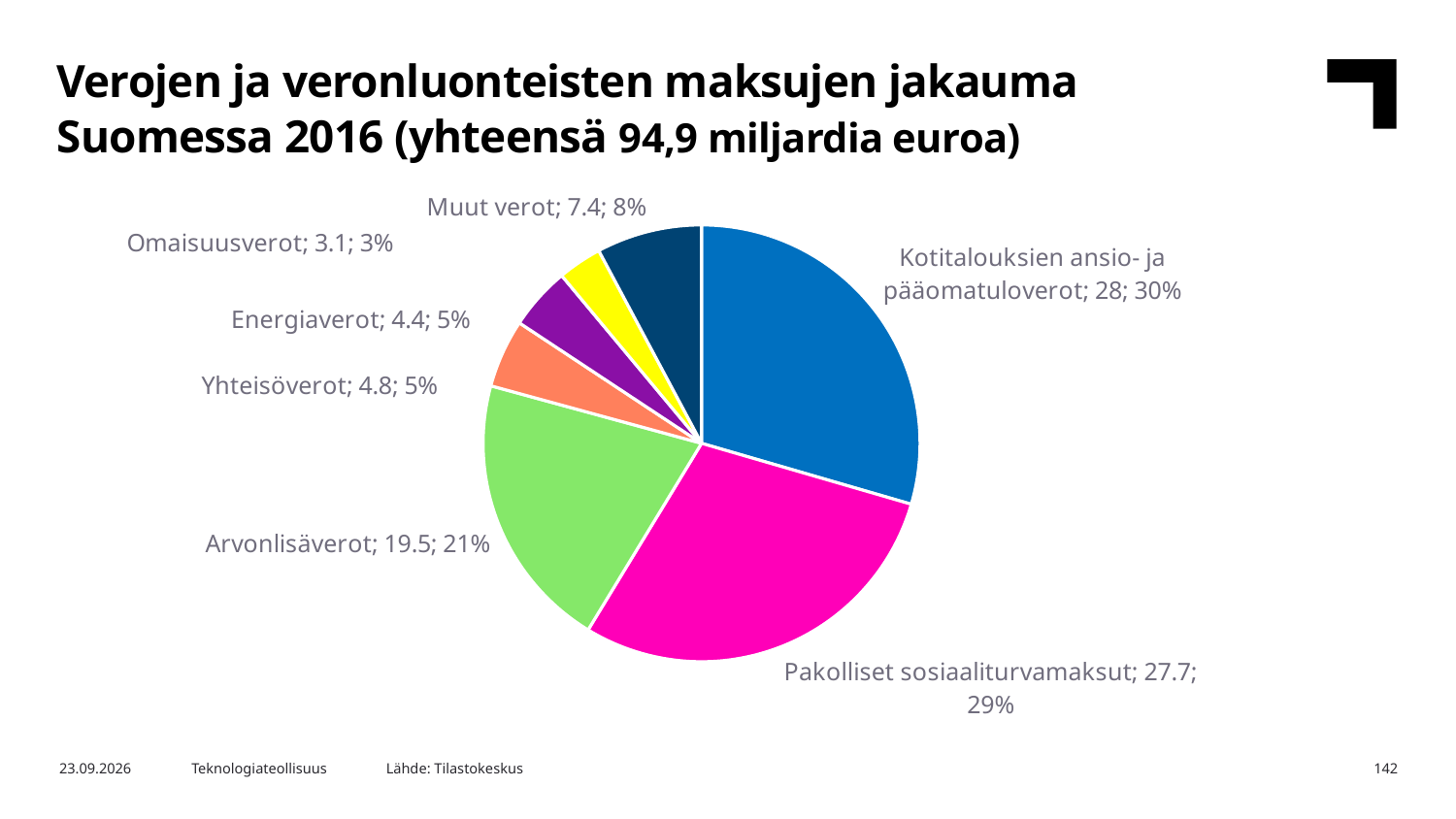
What kind of chart is shown on the slide? Pie chart What value is shown for Energiaverot? 4.4 What share of the pie does Arvonlisäverot represent? 21% What is the difference between the values for Muut verot and Energiaverot? 3 What is the difference between the values for Arvonlisäverot and Yhteisöverot? 14.7 What value is shown for Muut verot? 7.4 Which category has the largest slice of the pie? Kotitalouksien ansio- ja pääomatuloverot Which is larger, the value for Yhteisöverot or the value for Omaisuusverot? Yhteisöverot What value is shown for Arvonlisäverot? 19.5 What value is shown for Pakolliset sosiaaliturvamaksut? 27.7 How many slices does the pie chart have? 7 Which category has the smallest slice of the pie? Omaisuusverot